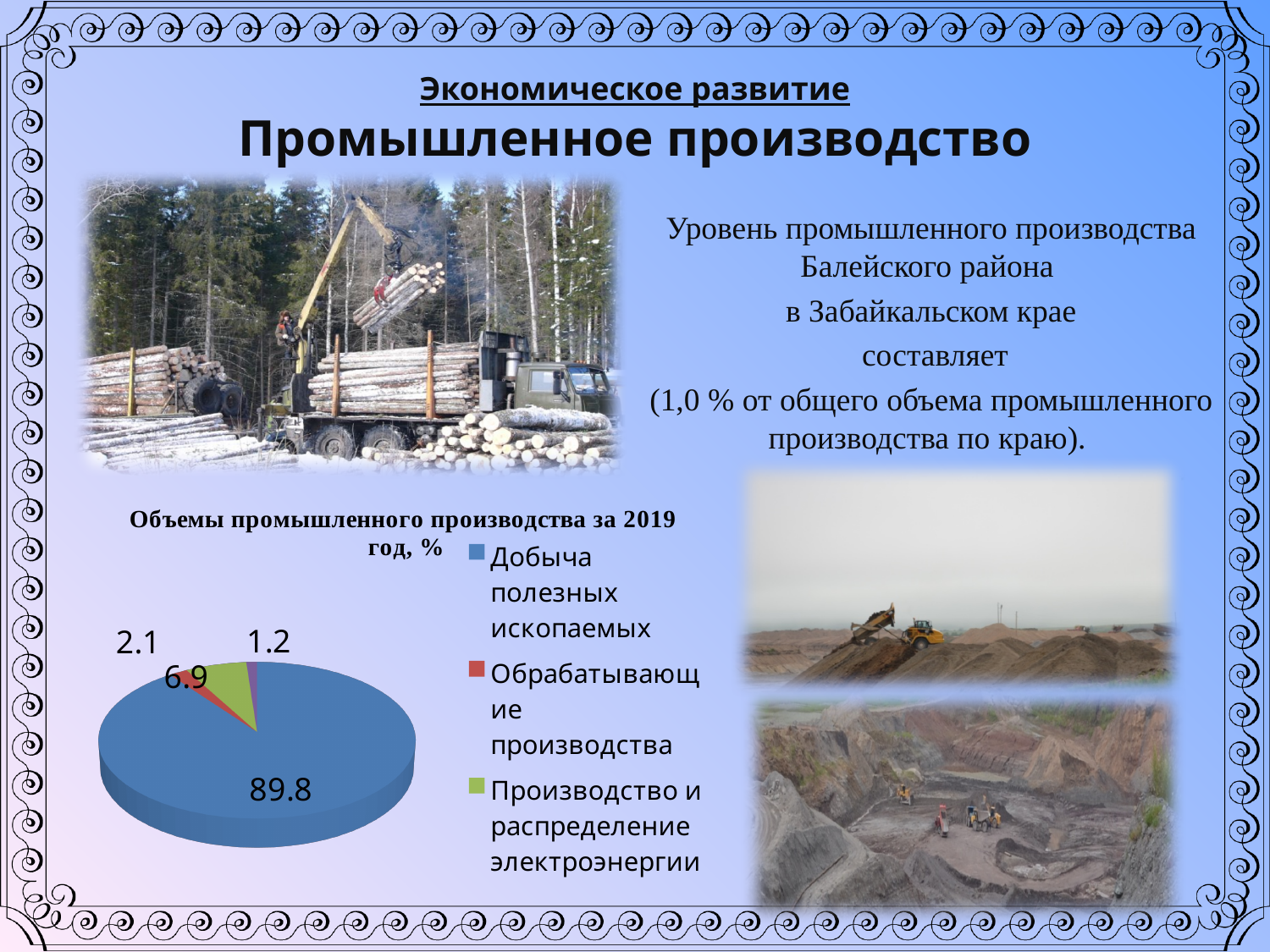
What is the difference between the values for Обрабатывающие производства and Производство и распределение электроэнергии? 4.8 What is the difference between the values for Добыча полезных ископаемых and Обрабатывающие производства? 87.7 What is the value for Добыча полезных ископаемых in the pie chart? 89.8 What is the value for Обрабатывающие производства in the pie chart? 2.1 What is the smallest value labelled on the pie chart? 1.2 Which category has the largest slice of the pie chart? Добыча полезных ископаемых How many entries does the chart legend list? 3 How many data labels are shown on the pie chart? 4 What is the title of the chart? Объемы промышленного производства за 2019 год, % What is the value for Производство и распределение электроэнергии in the pie chart? 6.9 What type of chart is shown on the slide? Pie chart Which is larger: Обрабатывающие производства or Производство и распределение электроэнергии? Производство и распределение электроэнергии